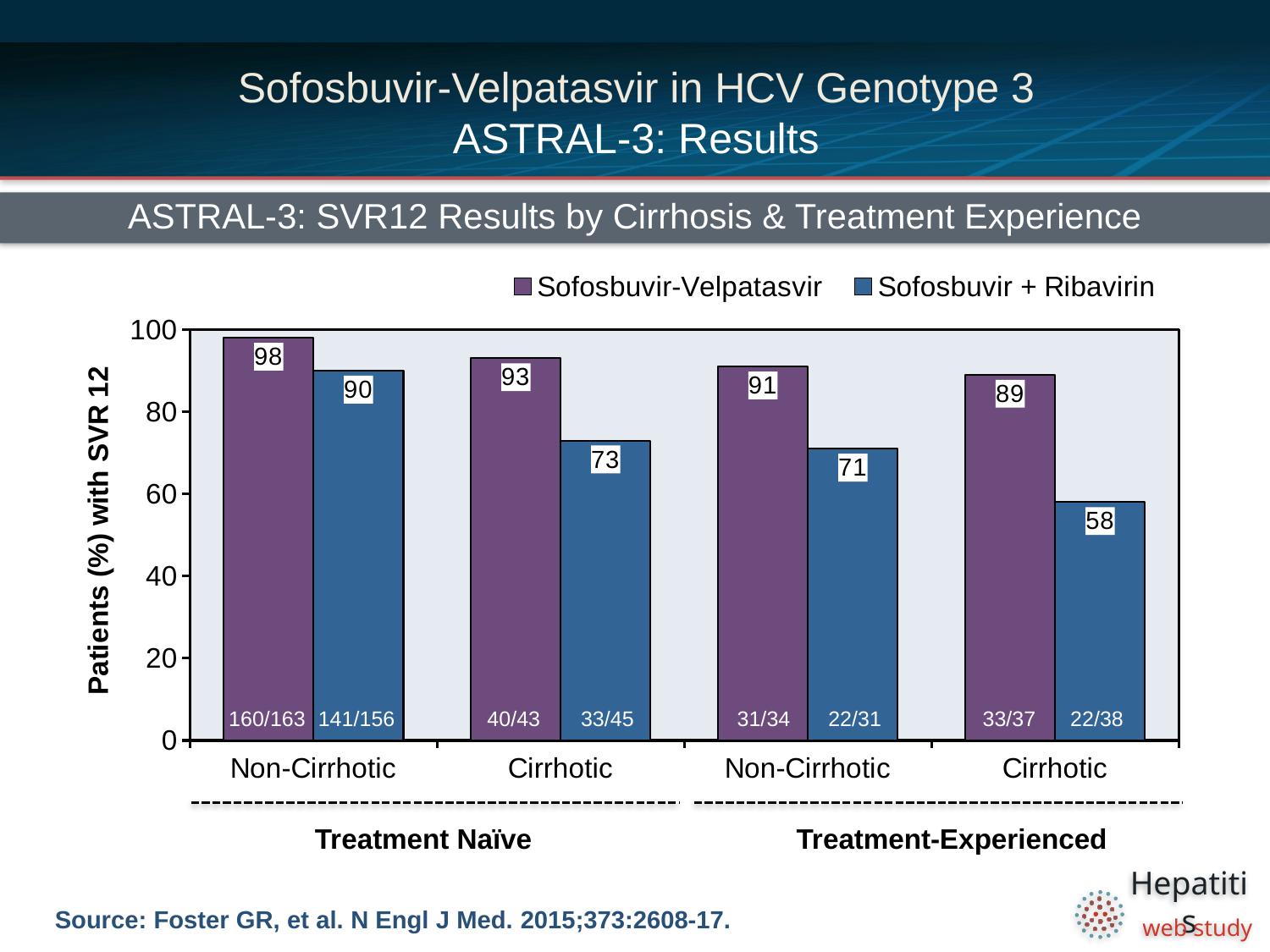
Which is larger in Treatment-Experienced Non-Cirrhotic patients: the SVR12 rate for Sofosbuvir-Velpatasvir or for Sofosbuvir + Ribavirin? Sofosbuvir-Velpatasvir What is the SVR12 rate for Sofosbuvir + Ribavirin in Treatment-Experienced Cirrhotic patients? 58 What is the SVR12 rate for Sofosbuvir-Velpatasvir in Treatment Naïve Non-Cirrhotic patients? 98 Is the SVR12 rate for Sofosbuvir + Ribavirin in Treatment-Experienced Cirrhotic patients greater or less than 60? less Which group has the lowest SVR12 rate for Sofosbuvir + Ribavirin? Treatment-Experienced Cirrhotic What is the difference between the Sofosbuvir-Velpatasvir and Sofosbuvir + Ribavirin SVR12 rates in Treatment-Experienced Cirrhotic patients? 31 How many series does the legend list? 2 What kind of chart is shown on the slide? bar chart What is the SVR12 rate for Sofosbuvir + Ribavirin in Treatment Naïve Cirrhotic patients? 73 What is the label of the y axis? Patients (%) with SVR 12 What is the patient fraction shown for Sofosbuvir-Velpatasvir in Treatment Naïve Non-Cirrhotic patients? 160/163 Which group has the highest SVR12 rate for Sofosbuvir-Velpatasvir? Treatment Naïve Non-Cirrhotic